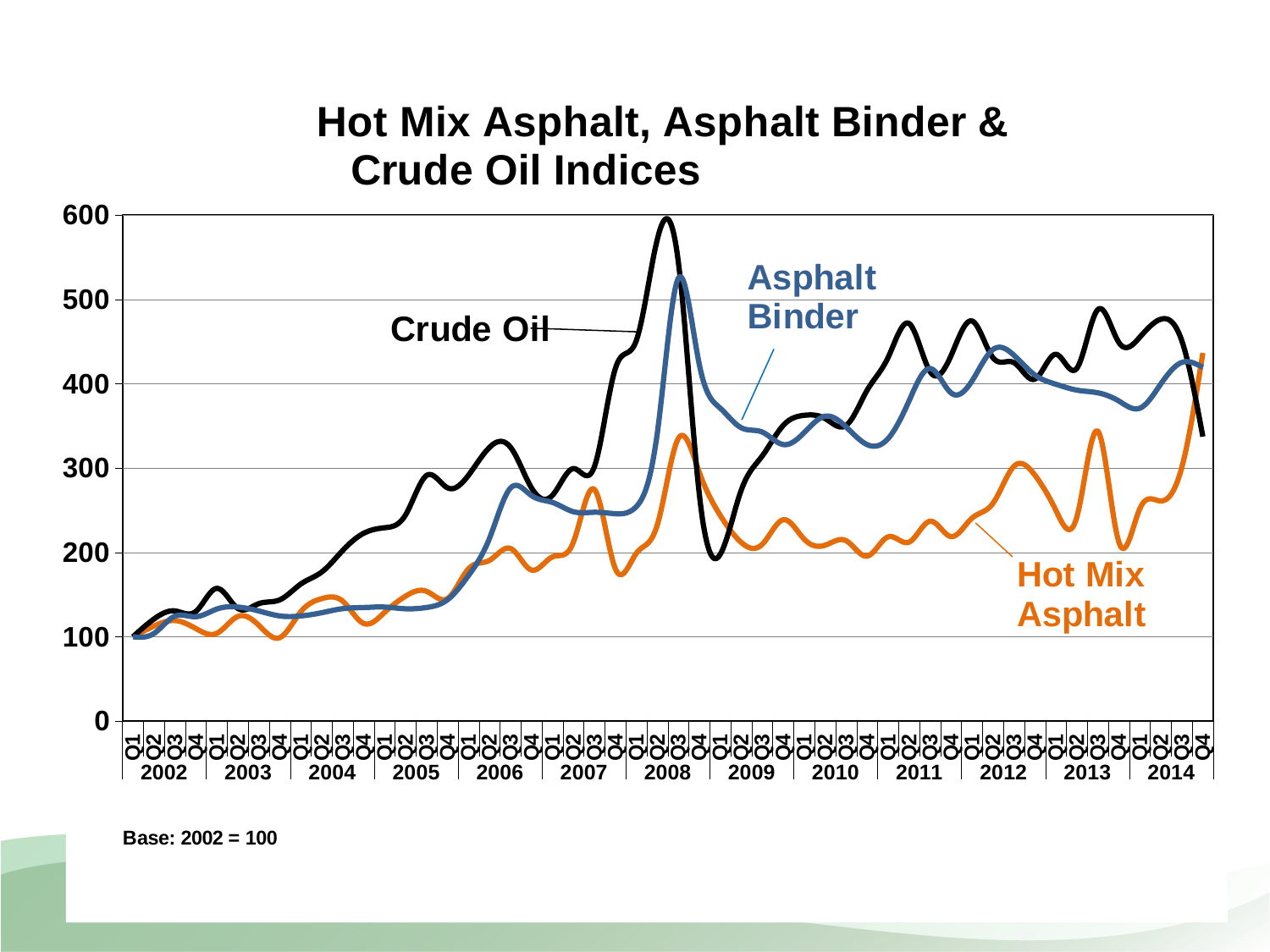
In which year does the Crude Oil index reach its highest point? 2008 What kind of chart is shown on the slide? Line chart Which is higher in Q4 2014, Hot Mix Asphalt or Crude Oil? Hot Mix Asphalt Is the peak value of Crude Oil in 2008 greater or less than 500? greater How many series are plotted on the chart? 3 Is the peak value of Hot Mix Asphalt in 2008 greater or less than 400? less Which series reaches the highest peak on the chart? Crude Oil Is the value for Crude Oil in Q4 2014 greater or less than 400? less Which is higher in Q2 2008, Crude Oil or Hot Mix Asphalt? Crude Oil What base value does the note below the chart state for 2002? 100 What is the title of the chart? Hot Mix Asphalt, Asphalt Binder & Crude Oil Indices How many years are labelled along the x axis? 13